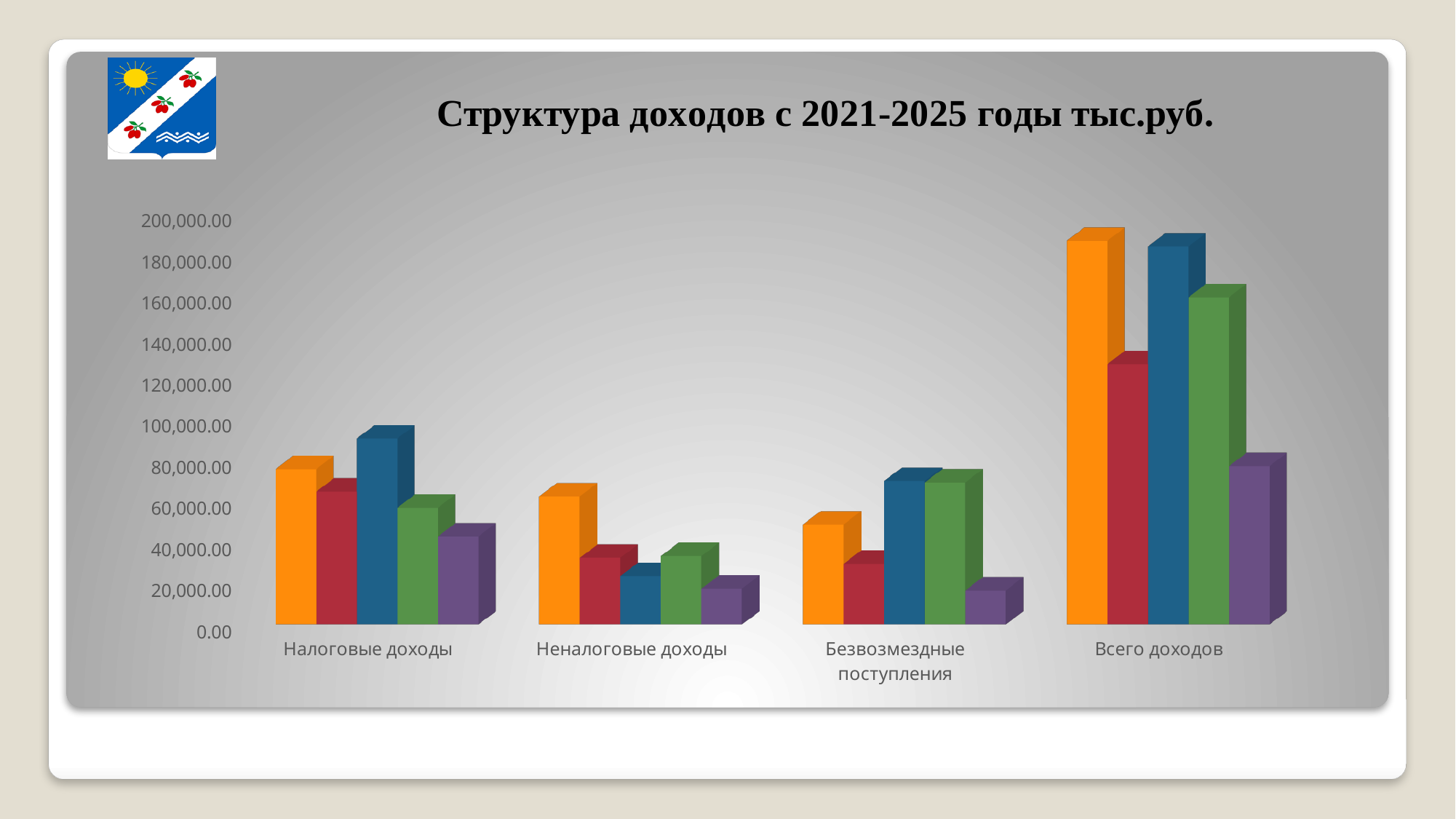
Is the value of the blue (third) bar for Неналоговые доходы greater or less than 40,000.00? less How many categories are shown on the x axis of the chart? 4 Within the category Всего доходов, which bar is the lowest? the purple (fifth) bar Is the value of the orange (first) bar for Всего доходов greater or less than 180,000.00? greater Is the value of the purple (fifth) bar for Всего доходов greater or less than 100,000.00? less What is the title of the chart? Структура доходов с 2021-2025 годы тыс.руб. What kind of chart is shown on the slide? bar chart Which is larger: the orange (first) bar for Налоговые доходы or the orange (first) bar for Неналоговые доходы? Налоговые доходы Within the category Налоговые доходы, which bar is the tallest? the blue (third) bar Which is larger: the blue (third) bar for Безвозмездные поступления or the blue (third) bar for Неналоговые доходы? Безвозмездные поступления How many bars are plotted for each category? 5 Which category has the tallest bars overall? Всего доходов